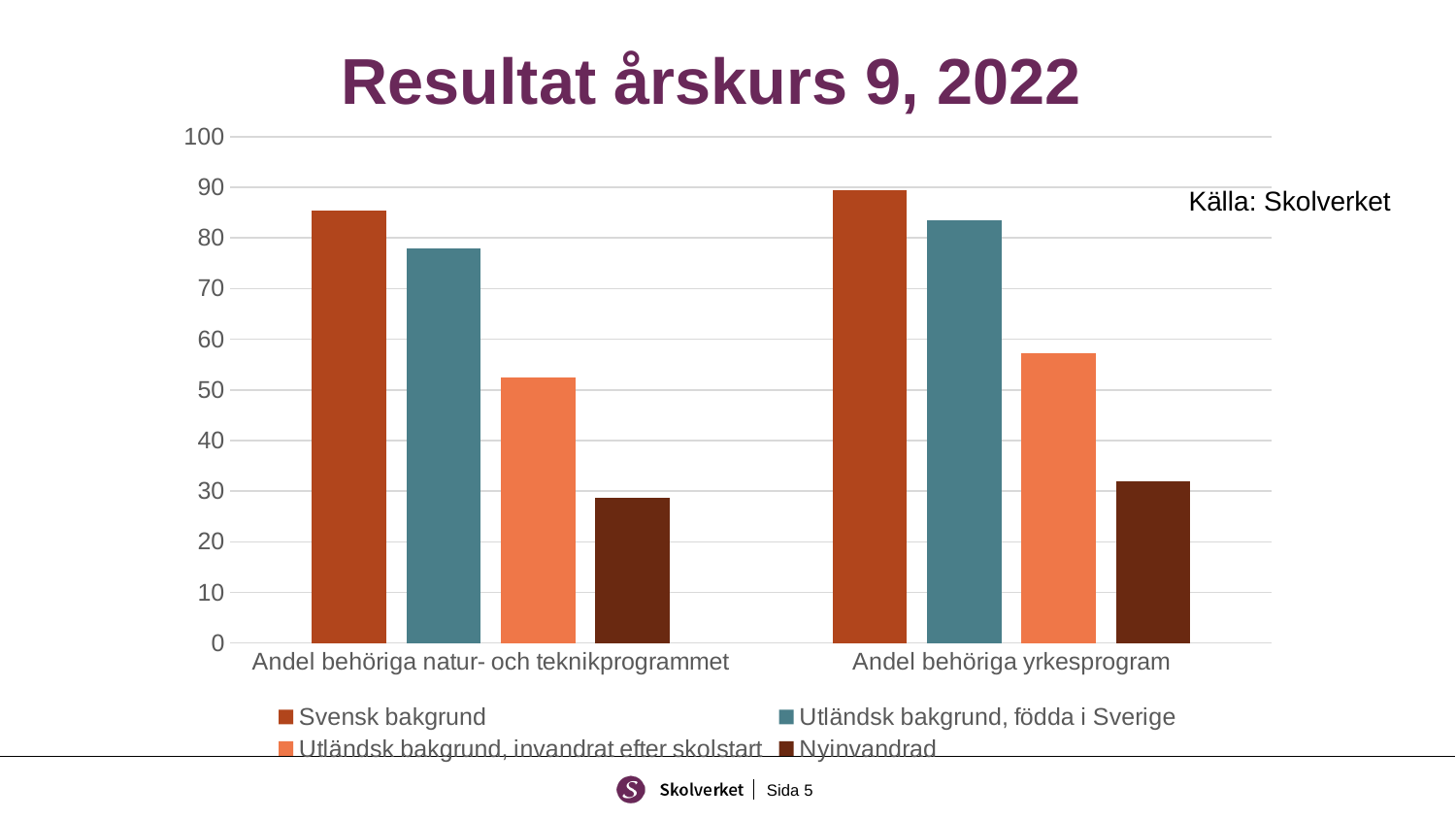
What source is cited for the chart? Skolverket Which is larger: 'Svensk bakgrund' for 'Andel behöriga natur- och teknikprogrammet' or 'Svensk bakgrund' for 'Andel behöriga yrkesprogram'? Andel behöriga yrkesprogram What kind of chart is shown on the slide? Bar chart Which is larger for 'Andel behöriga yrkesprogram': 'Utländsk bakgrund, födda i Sverige' or 'Utländsk bakgrund, invandrat efter skolstart'? Utländsk bakgrund, födda i Sverige Is the value for 'Svensk bakgrund' in 'Andel behöriga natur- och teknikprogrammet' greater or less than 80? greater How many series does the legend list? 4 How many categories are shown on the x axis? 2 Which series has the lowest value for 'Andel behöriga natur- och teknikprogrammet'? Nyinvandrad Is the value for 'Nyinvandrad' in 'Andel behöriga natur- och teknikprogrammet' greater or less than 30? less Which series has the highest value for 'Andel behöriga yrkesprogram'? Svensk bakgrund What is the title of the chart? Resultat årskurs 9, 2022 Is the value for 'Utländsk bakgrund, invandrat efter skolstart' in 'Andel behöriga yrkesprogram' greater or less than 50? greater